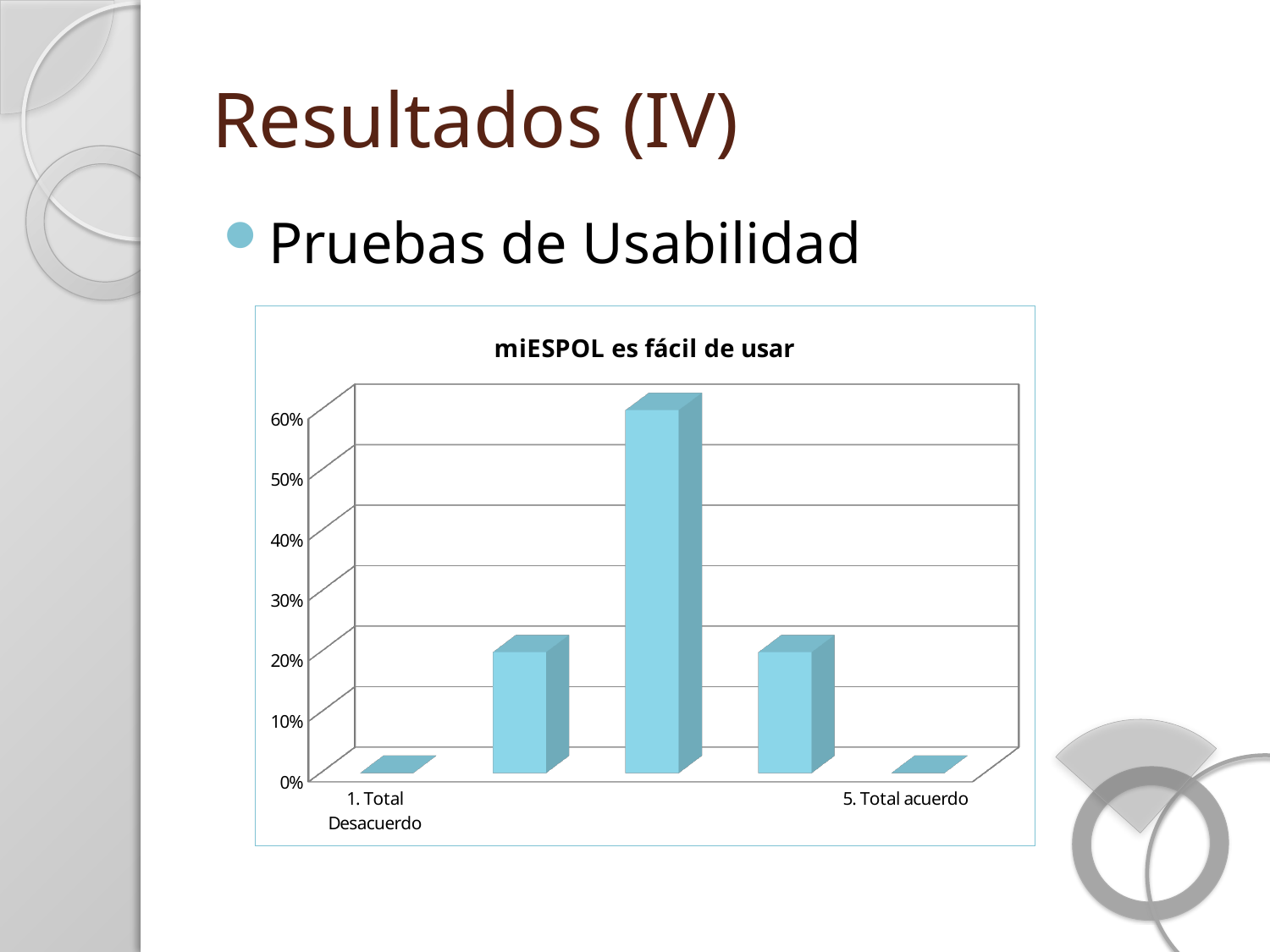
How many bars are plotted in the 'miESPOL es fácil de usar' chart? 5 What is the value for '5. Total acuerdo' in the chart? 0% Is the value of the fourth bar from the left greater or less than 40%? less Is the value of the second bar from the left greater or less than 30%? less What kind of chart is shown under 'miESPOL es fácil de usar'? bar chart Which is larger: the middle bar or the bar for '1. Total Desacuerdo'? the middle bar Is the value of the tallest (middle) bar in the chart greater or less than 50%? greater What is the title of the chart on the slide? miESPOL es fácil de usar What is the highest value shown on the vertical axis of the chart? 60% What is the value for '1. Total Desacuerdo' in the chart? 0%